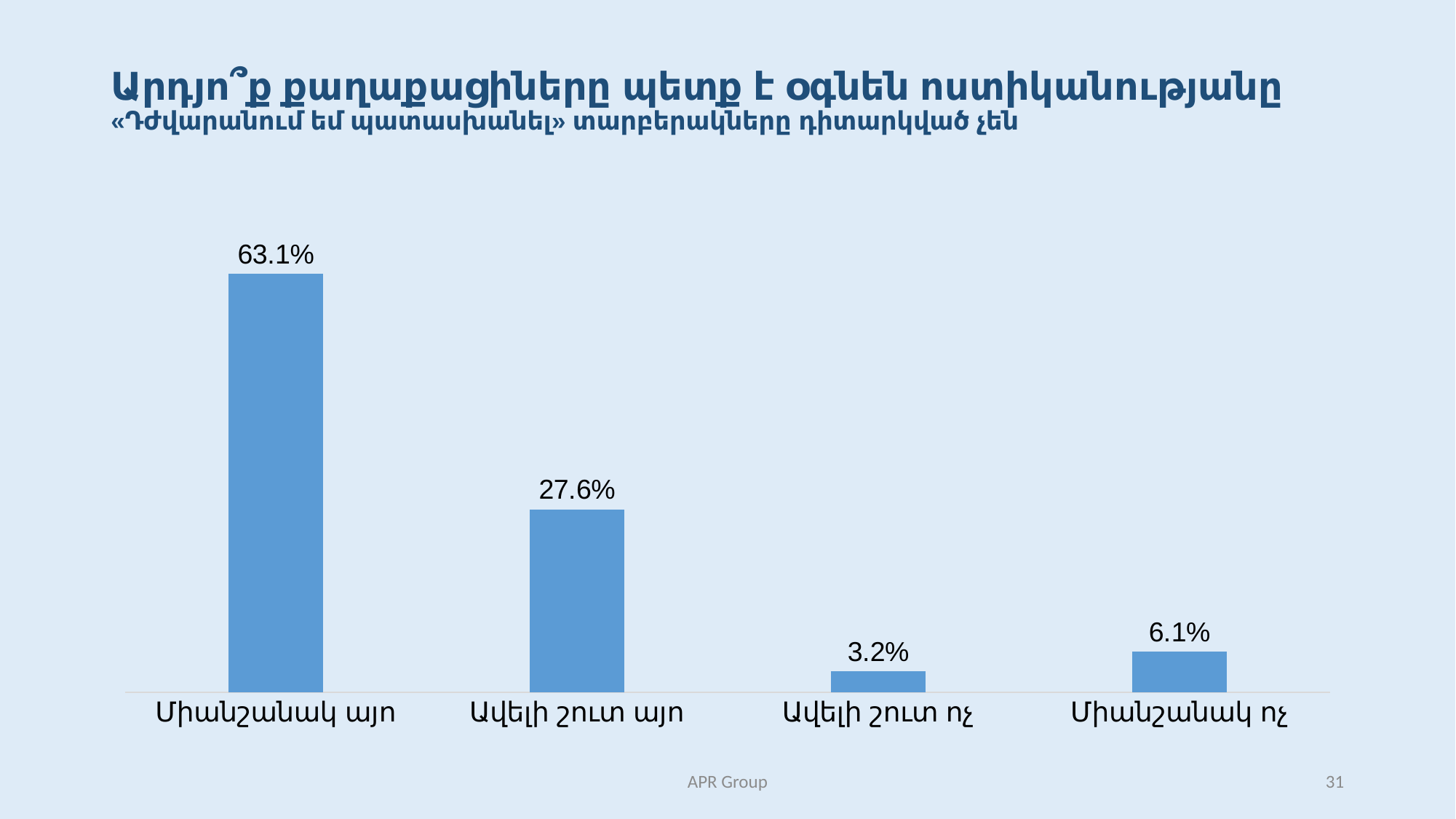
How many categories are shown in the chart? 4 What is the title of the slide? Արդյո՞ք քաղաքացիները պետք է օգնեն ոստիկանությանը What is the difference between the values for Միանշանակ ոչ and Ավելի շուտ ոչ? 2.9% Which category has the highest value? Միանշանակ այո What kind of chart is shown on the slide? Bar chart What is the value for Միանշանակ ոչ? 6.1% What is the value for Ավելի շուտ այո? 27.6% Which is larger, the value for Միանշանակ ոչ or the value for Ավելի շուտ ոչ? Միանշանակ ոչ What is the value for Միանշանակ այո? 63.1% What is the difference between the values for Միանշանակ այո and Ավելի շուտ այո? 35.5% What is the value for Ավելի շուտ ոչ? 3.2% Which category has the lowest value? Ավելի շուտ ոչ